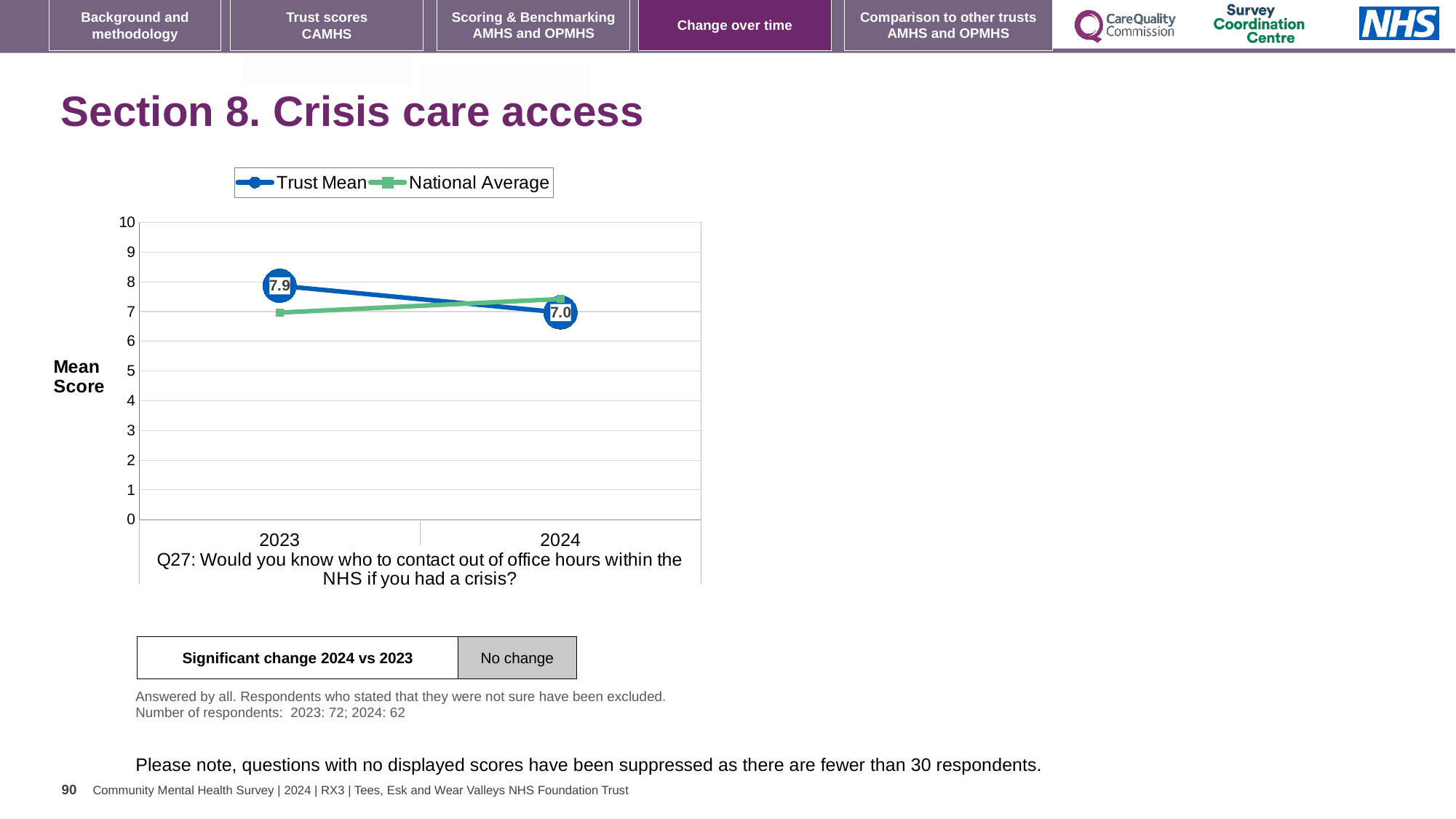
How many years are plotted on the x axis? 2 What type of chart is shown on the slide? line chart What is the label on the y axis of the chart? Mean Score Does the National Average rise or fall from 2023 to 2024? rise What is the Trust Mean score for 2024? 7.0 Does the Trust Mean rise or fall from 2023 to 2024? fall How many series does the legend list? 2 Is the National Average value for 2024 greater or less than 8? less In 2023, which is higher, the Trust Mean or the National Average? Trust Mean What is the Trust Mean score for 2023? 7.9 What is the difference between the Trust Mean in 2023 and in 2024? 0.9 Which year has the higher Trust Mean, 2023 or 2024? 2023